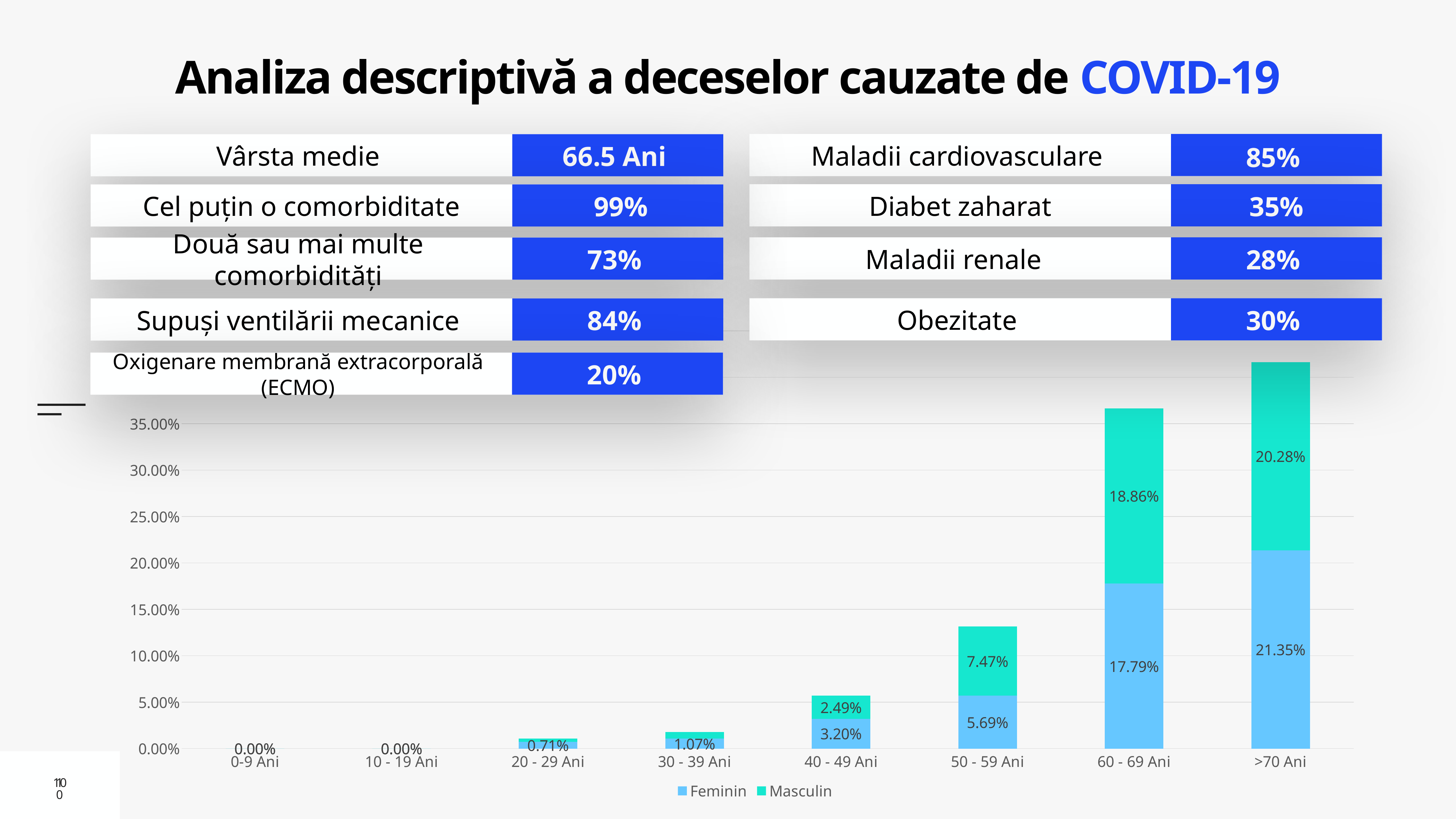
Which age group has the tallest stacked bar? >70 Ani Do the stacked bar totals rise or fall as age increases along the x axis? rise What is the difference between the Masculin and Feminin values for the 60 - 69 Ani age group? 1.07% What kind of chart is shown on the slide? stacked bar chart What is the Feminin value for the 60 - 69 Ani age group? 17.79% What is the total of the stacked bar for the 60 - 69 Ani age group? 36.65% How many age groups are shown on the x axis of the chart? 8 In the 50 - 59 Ani age group, which is larger, the Feminin or the Masculin value? Masculin How many series does the chart legend list? 2 What is the Masculin value for the >70 Ani age group? 20.28% What is the Feminin value for the 40 - 49 Ani age group? 3.20% What is the Masculin value for the 50 - 59 Ani age group? 7.47%